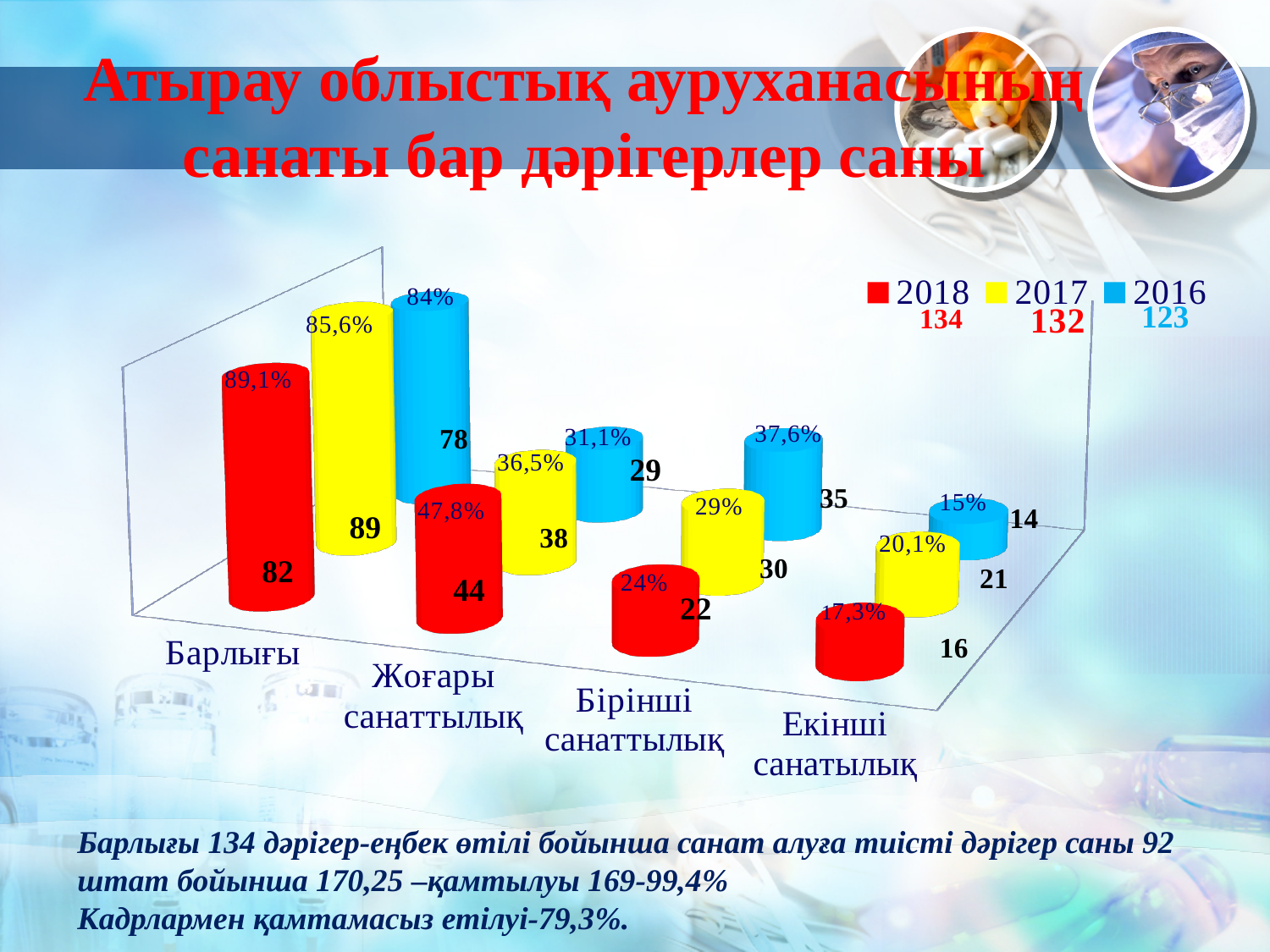
What kind of chart is shown on the slide? bar chart Which is larger in the Бірінші санаттылық category: the 2018 value or the 2016 value? 2016 Which colour represents the 2017 series in the chart? yellow What percentage is shown for 2016 in the Бірінші санаттылық category? 37,6% What is the value for 2016 in the Екінші санатылық category? 14 Which category has the highest value for the 2018 series? Барлығы What is the value for 2017 in the Жоғары санаттылық category? 38 How many categories are shown on the x axis of the chart? 4 How many series does the legend list? 3 What is the value for 2018 in the Барлығы category? 82 Which category has the lowest value for the 2017 series? Екінші санатылық What is the difference between the 2017 and 2016 values in the Барлығы category? 11